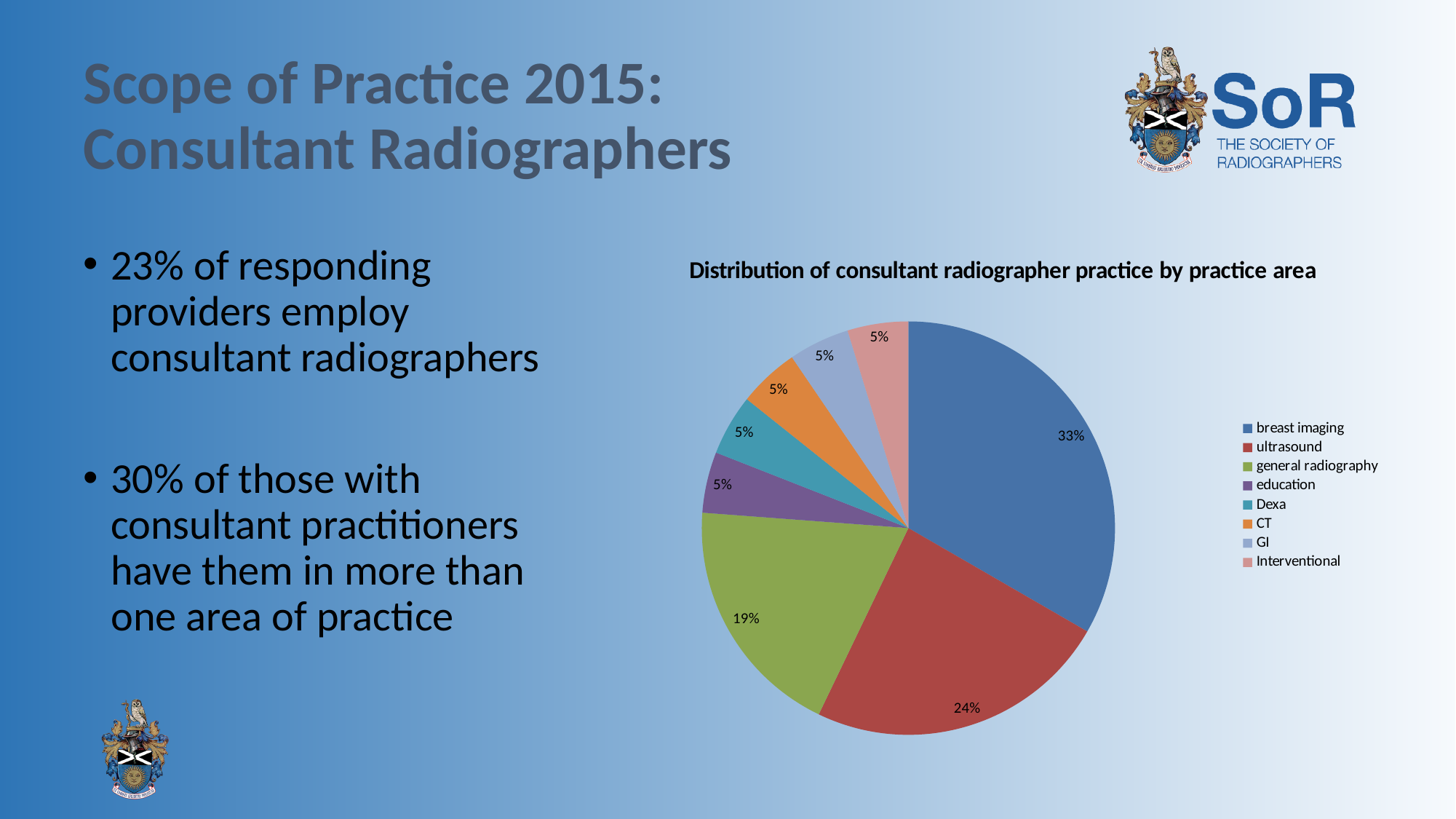
What is the difference between the breast imaging share and the ultrasound share? 9% What is the difference between the general radiography share and the education share? 14% What share of the pie does breast imaging account for? 33% Which colour represents ultrasound in the pie chart? red How many practice areas does the legend list? 8 What share of the pie does ultrasound account for? 24% What is the title of the chart? Distribution of consultant radiographer practice by practice area What kind of chart is shown on the slide? pie chart Which is larger, the ultrasound slice or the general radiography slice? ultrasound Which practice area has the largest slice of the pie? breast imaging What share of the pie does CT account for? 5%